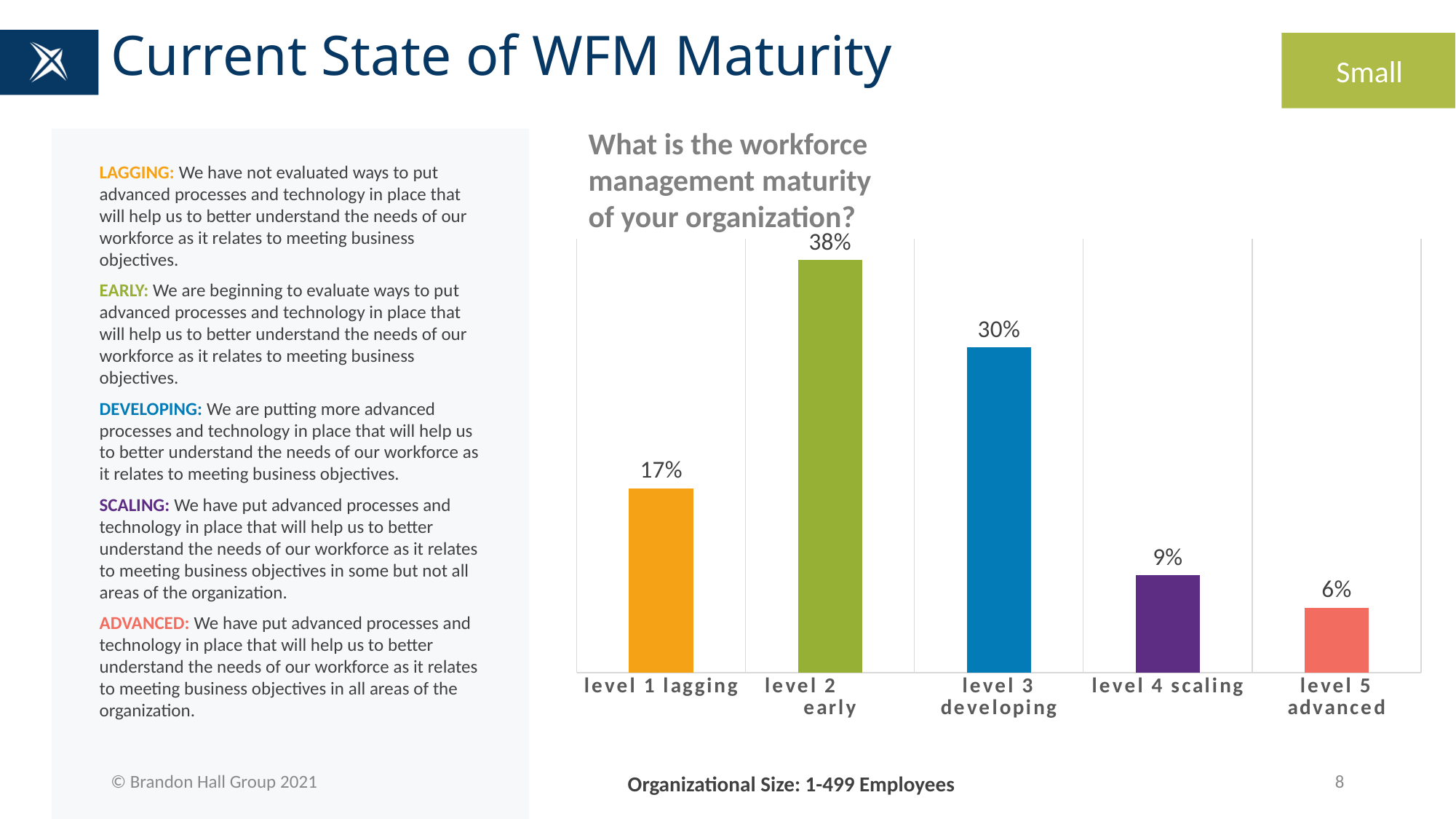
Which maturity level has the highest percentage? level 2 early What percentage of organizations are at level 2 early? 38% What kind of chart is shown on the slide? bar chart Which maturity level has the lowest percentage? level 5 advanced What is the title of the chart? What is the workforce management maturity of your organization? Which is larger, the value for level 3 developing or level 1 lagging? level 3 developing What is the value for level 4 scaling? 9% How many maturity levels are shown in the chart? 5 What is the difference between the values for level 1 lagging and level 5 advanced? 11% What is the difference between the values for level 2 early and level 3 developing? 8% What colour is the bar for level 3 developing? blue What is the value for level 1 lagging? 17%